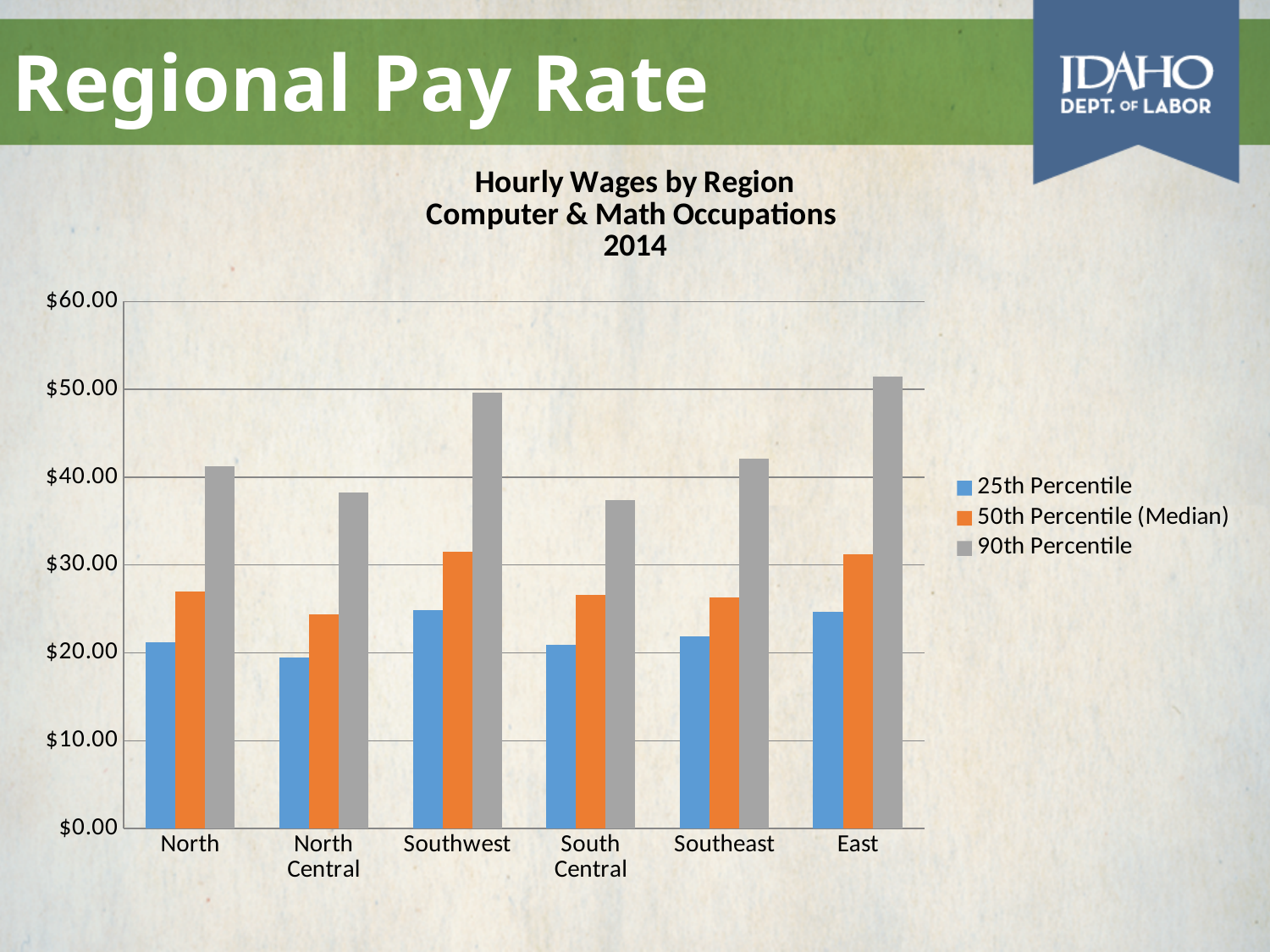
Is the 90th Percentile value for East greater or less than $50.00? greater How many series does the chart's legend list? 3 Which is larger, the 90th Percentile value for Southeast or for North Central? Southeast Which series is shown in orange in the chart's legend? 50th Percentile (Median) Is the 90th Percentile value for South Central greater or less than $40.00? less How many regions are shown on the x axis of the chart? 6 Which region has the lowest 25th Percentile hourly wage? North Central Which region has the highest 90th Percentile hourly wage? East Is the 25th Percentile value for North Central greater or less than $20.00? less Which region has the lowest 50th Percentile (Median) hourly wage? North Central What type of chart is shown on the slide? bar chart